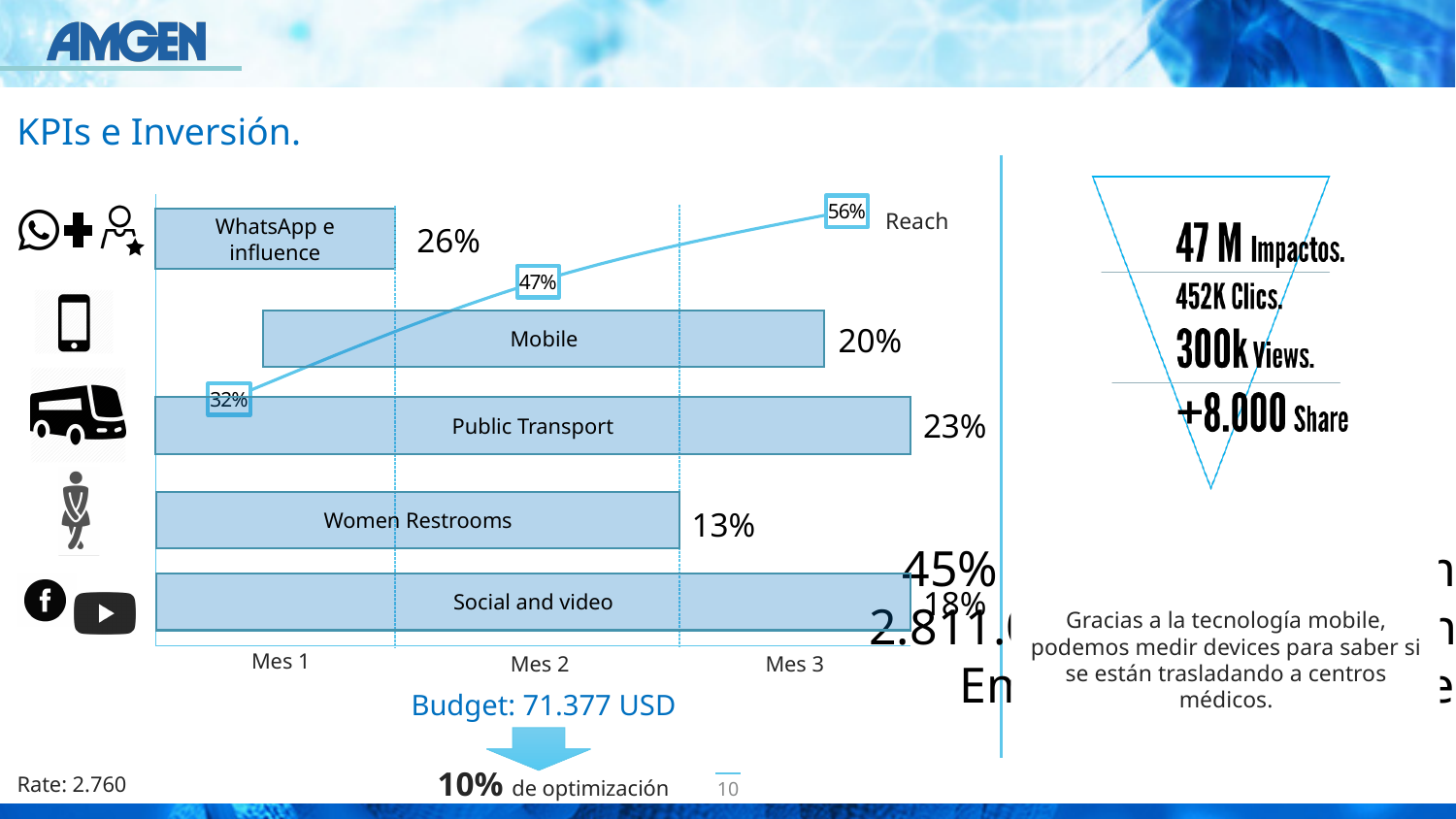
What percentage is shown next to the Mobile bar? 20% How many channel bars are shown in the chart? 5 What is the difference between the Reach values at Mes 3 and Mes 1? 24% What percentage is shown next to the Public Transport bar? 23% What percentage is shown next to the Women Restrooms bar? 13% What is the Reach value at Mes 3? 56% Which channel has the lowest percentage label? Women Restrooms What is the Reach value at Mes 2? 47% Does the Reach line rise or fall from Mes 1 to Mes 3? rise What are the labels on the x axis of the chart? Mes 1, Mes 2, Mes 3 Which has a larger percentage label, Public Transport or Mobile? Public Transport Which channel has the highest percentage label? WhatsApp e influence